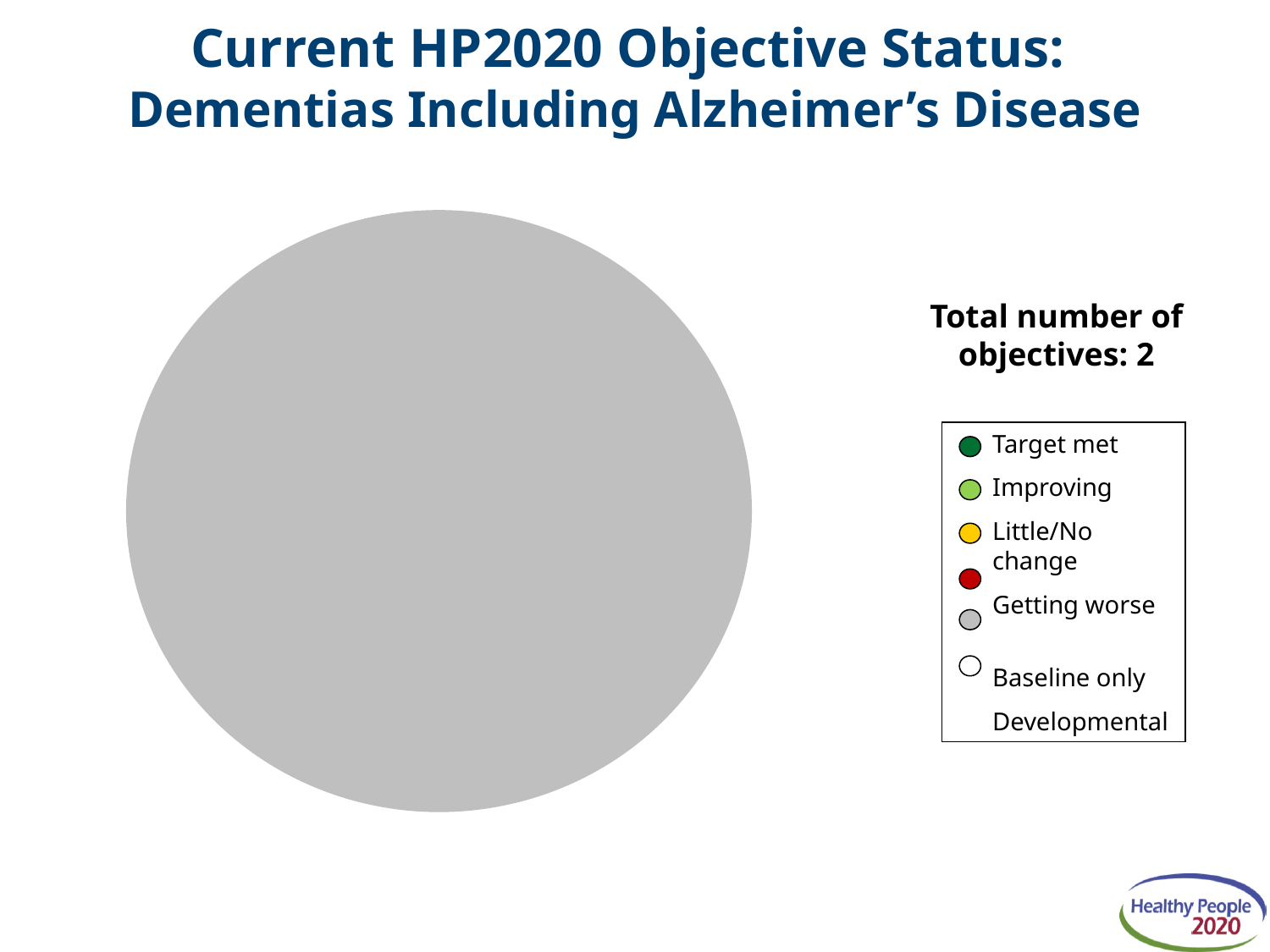
Does the pie chart show any slice for the 'Target met' category? No How many slices does the pie chart have? 1 Which legend entry is shown with a dark green marker? Target met What is the title of the slide containing the pie chart? Current HP2020 Objective Status: Dementias Including Alzheimer's Disease Which status category, according to the legend colour, does the entire pie chart represent? Baseline only What is the total number of objectives stated on the slide? 2 Which legend entry is shown with a red marker? Getting worse How many status categories does the legend list? 6 What colour is the pie chart? Gray What kind of chart is shown on the slide? Pie chart